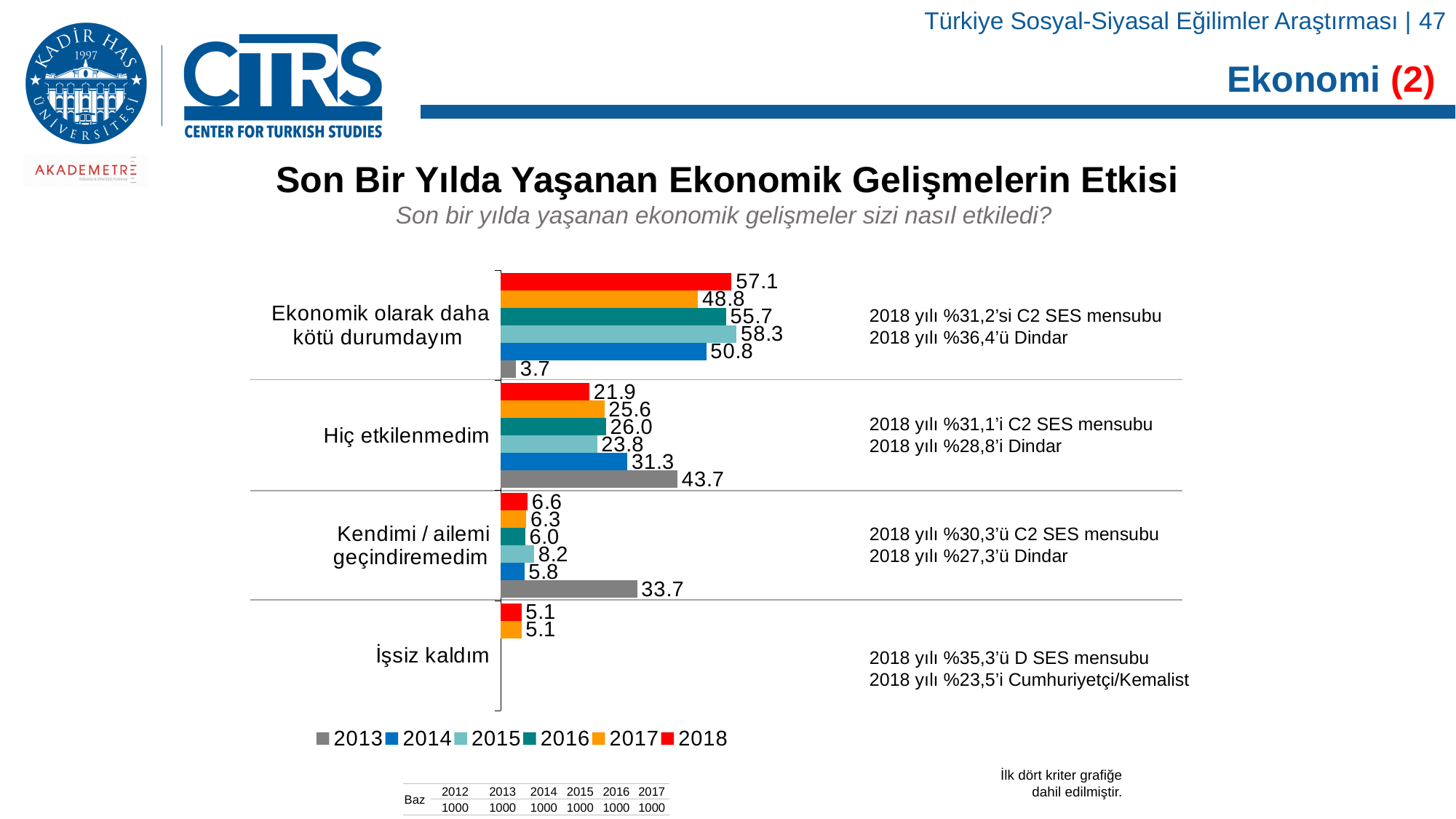
How many series does the legend list? 6 Which year has the lowest value for "Hiç etkilenmedim"? 2018 What is the 2017 value for "İşsiz kaldım"? 5.1 Which colour represents the 2013 series in the legend? grey Which is larger for "Hiç etkilenmedim": the 2014 value or the 2017 value? 2014 How many categories are shown on the chart? 4 What is the 2015 value for "Kendimi / ailemi geçindiremedim"? 8.2 What is the 2013 value for "Hiç etkilenmedim"? 43.7 What type of chart is shown on the slide? bar chart What is the 2018 value for "Ekonomik olarak daha kötü durumdayım"? 57.1 Which year has the highest value for "Ekonomik olarak daha kötü durumdayım"? 2015 What is the difference between the 2013 and 2014 values for "Kendimi / ailemi geçindiremedim"? 27.9